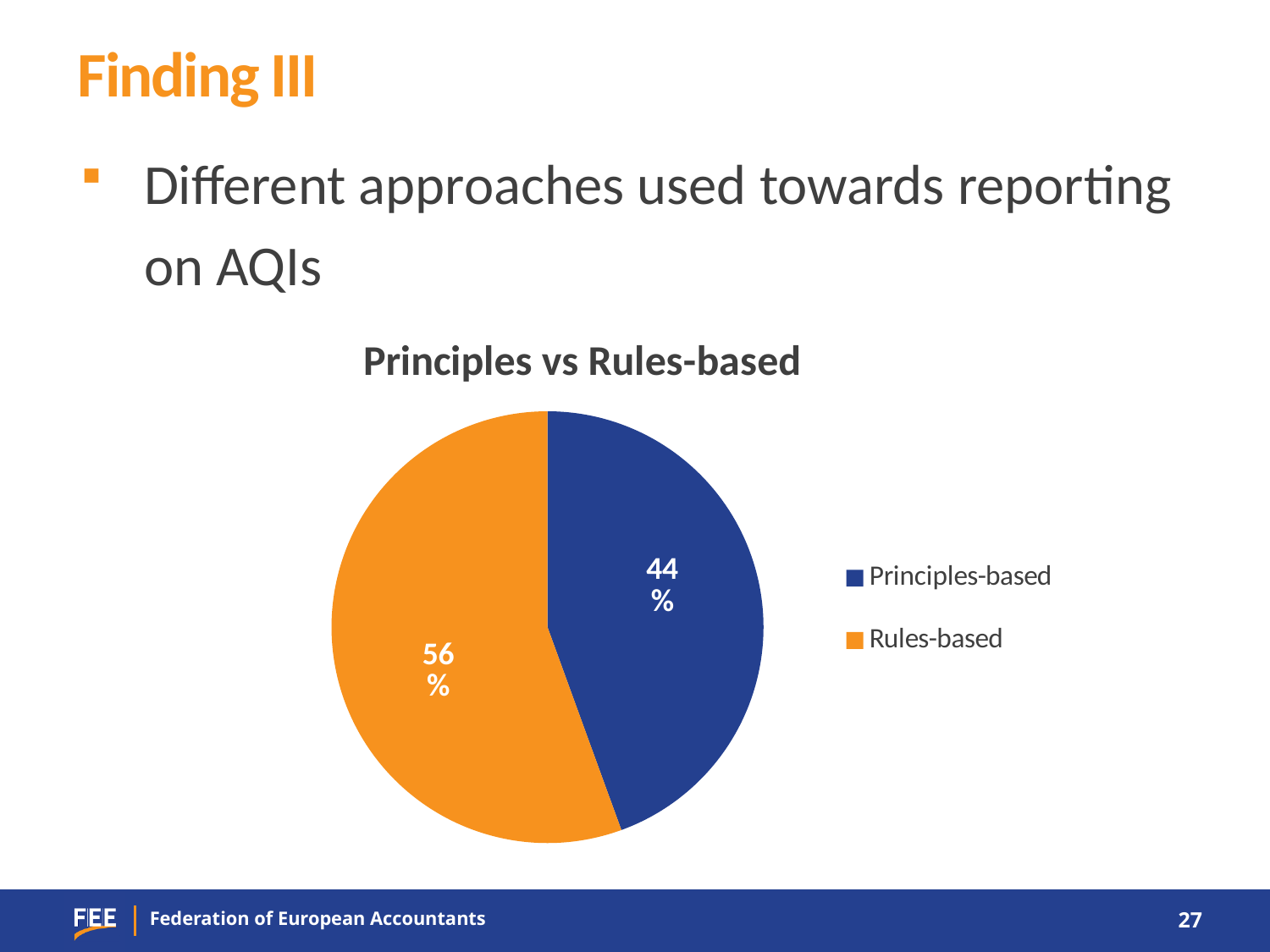
What kind of chart is shown on the slide? pie chart Which slice of the pie is the largest? Rules-based What is the difference in percentage points between the Rules-based and Principles-based slices? 12 How many slices does the pie chart have? 2 How many entries does the legend list? 2 Is the Principles-based share greater or less than 50%? less Which slice of the pie is the smallest? Principles-based What share of the pie is Principles-based? 44% What colour is the Rules-based slice? orange What is the title of the chart? Principles vs Rules-based Which is larger, the Principles-based slice or the Rules-based slice? Rules-based What share of the pie is Rules-based? 56%